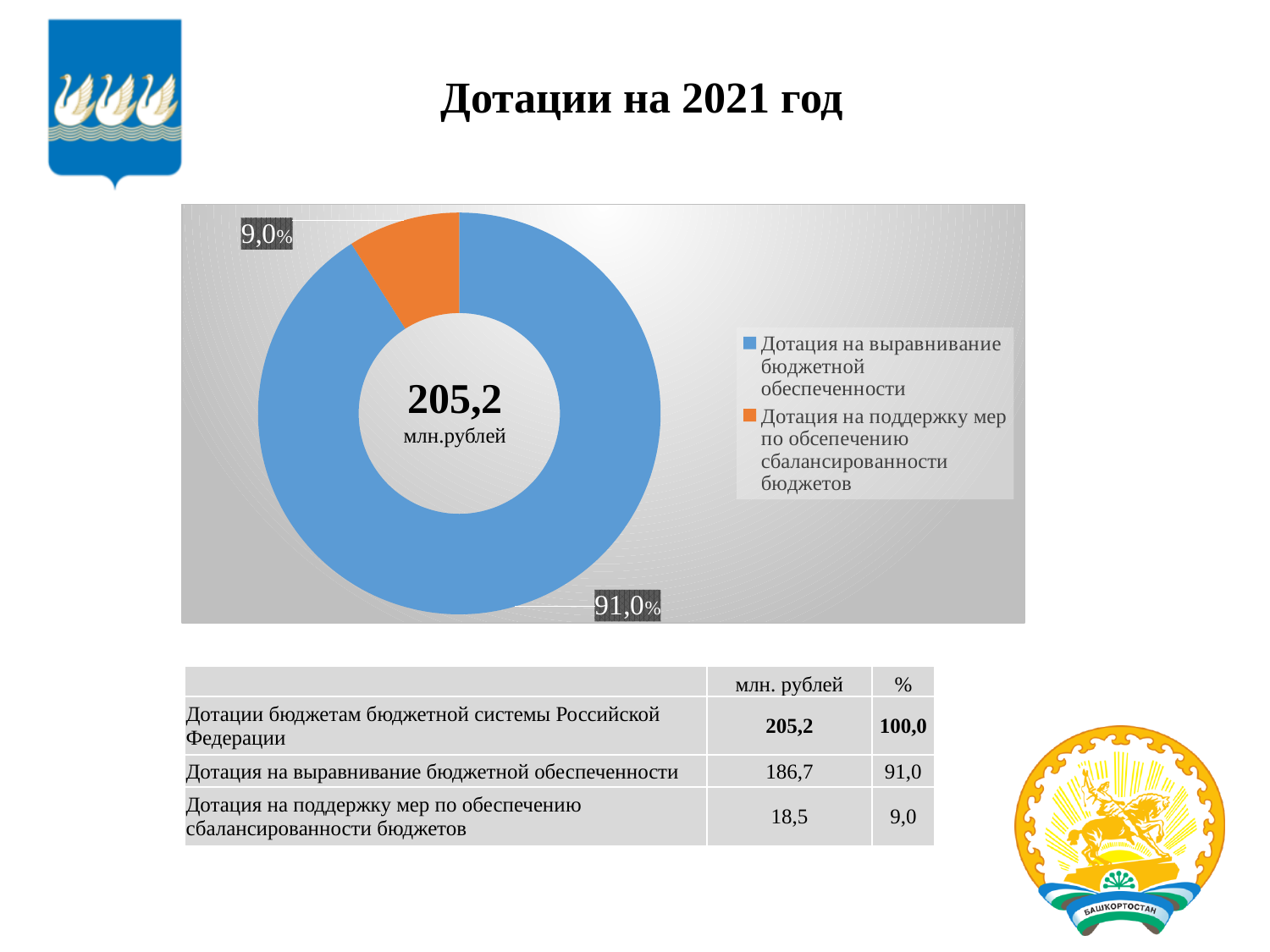
Which slice is larger: "Дотация на выравнивание бюджетной обеспеченности" or "Дотация на поддержку мер по обсепечению сбалансированности бюджетов"? Дотация на выравнивание бюджетной обеспеченности How many entries does the legend of the doughnut chart list? 2 What colour is the slice for "Дотация на поддержку мер по обсепечению сбалансированности бюджетов"? orange What kind of chart is shown on the slide? doughnut chart What is the title of the slide containing the doughnut chart? Дотации на 2021 год What is the difference in percentage points between the two slices of the doughnut chart? 82,0 How many slices does the doughnut chart have? 2 Which category has the largest slice in the doughnut chart? Дотация на выравнивание бюджетной обеспеченности What share of the doughnut chart does "Дотация на выравнивание бюджетной обеспеченности" take? 91,0% What share of the doughnut chart does "Дотация на поддержку мер по обсепечению сбалансированности бюджетов" take? 9,0% Which category has the smallest slice in the doughnut chart? Дотация на поддержку мер по обсепечению сбалансированности бюджетов What total value is printed in the centre of the doughnut chart? 205,2 млн.рублей